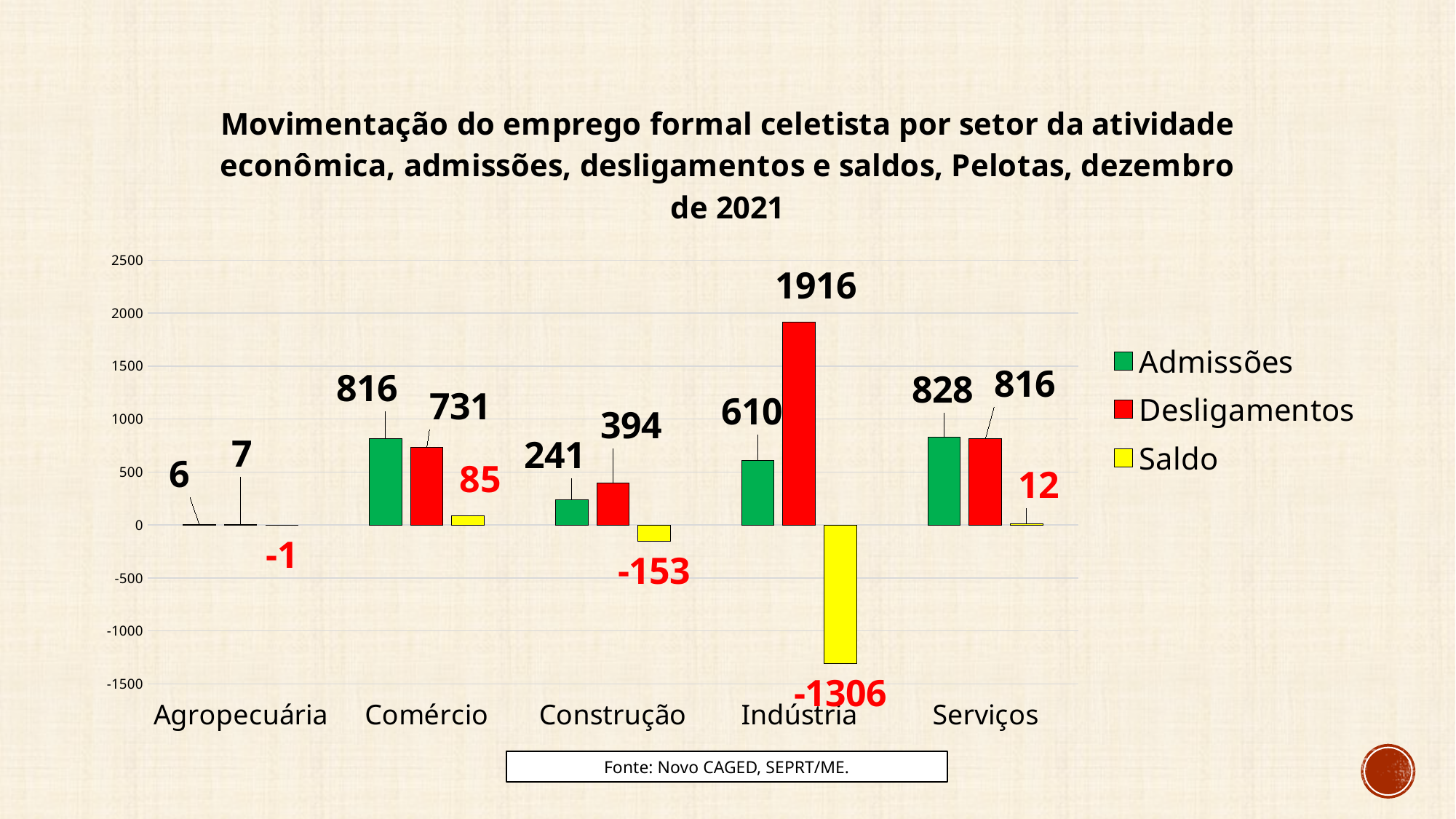
What is the difference between Admissões and Desligamentos for Serviços? 12 Which is larger for Construção: Admissões or Desligamentos? Desligamentos How many sectors are shown on the x axis? 5 Is the Desligamentos value for Indústria greater or less than 1500? greater What colour represents the Saldo series? Yellow Which sector has the highest Desligamentos value? Indústria What is the value of Admissões for Comércio? 816 How many series does the legend list? 3 What kind of chart is shown on the slide? Bar chart What is the Saldo value for Construção? -153 What is the value of Desligamentos for Indústria? 1916 Which sector has the lowest Saldo value? Indústria